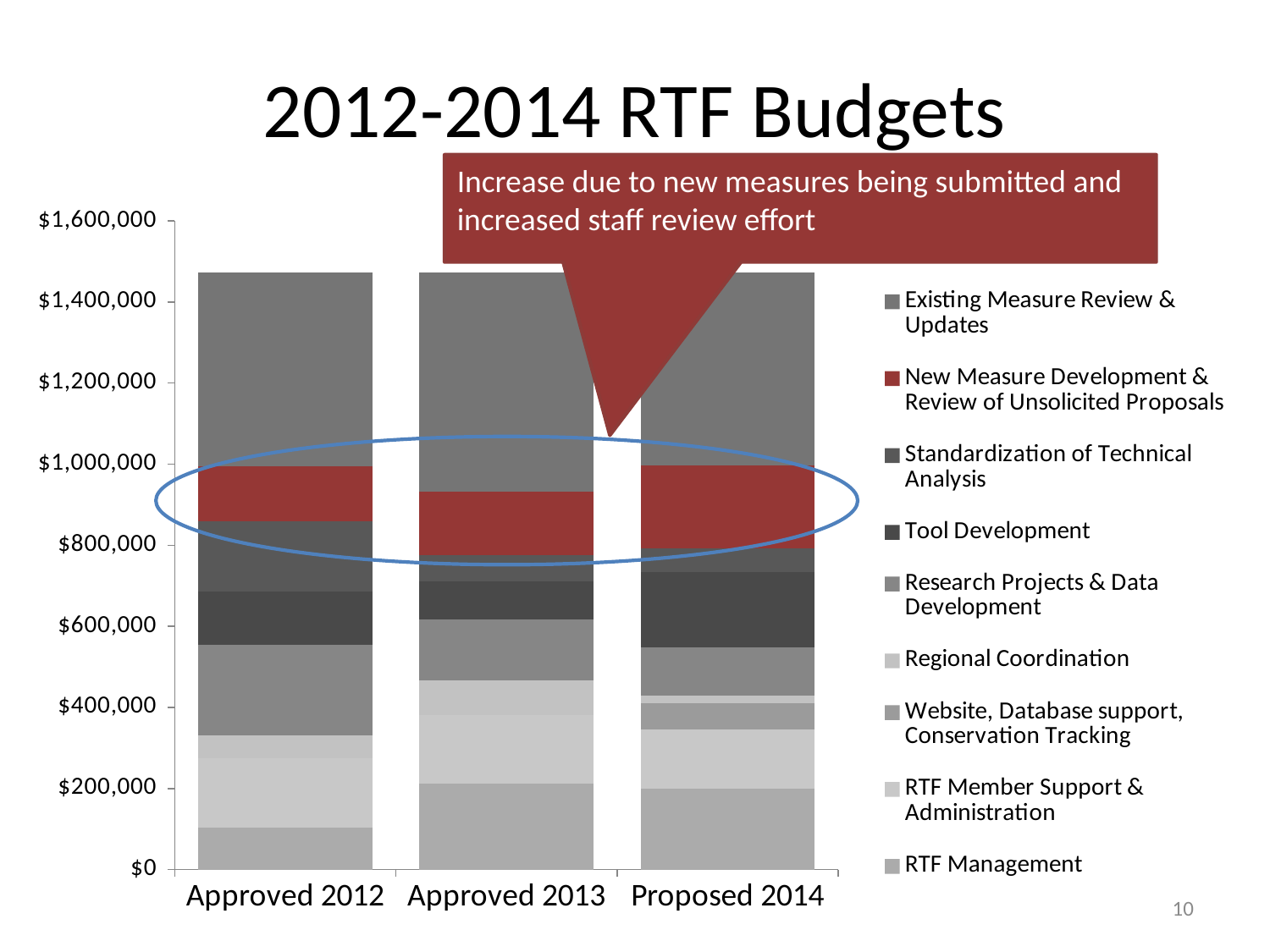
How many series does the legend list? 9 What is the title of the chart? 2012-2014 RTF Budgets Which legend entry is shown in red? New Measure Development & Review of Unsolicited Proposals Which bar has the larger New Measure Development & Review of Unsolicited Proposals segment, Approved 2012 or Proposed 2014? Proposed 2014 Is the total budget for Approved 2013 greater or less than $1,200,000? greater Is the total budget for Proposed 2014 greater or less than $1,600,000? less What is the label of the first category on the x axis? Approved 2012 What kind of chart is shown on the slide? Stacked bar chart Is the RTF Management segment for Approved 2012 greater or less than $200,000? less How many budget years (categories) are shown on the x axis? 3 Which category has the largest New Measure Development & Review of Unsolicited Proposals segment? Proposed 2014